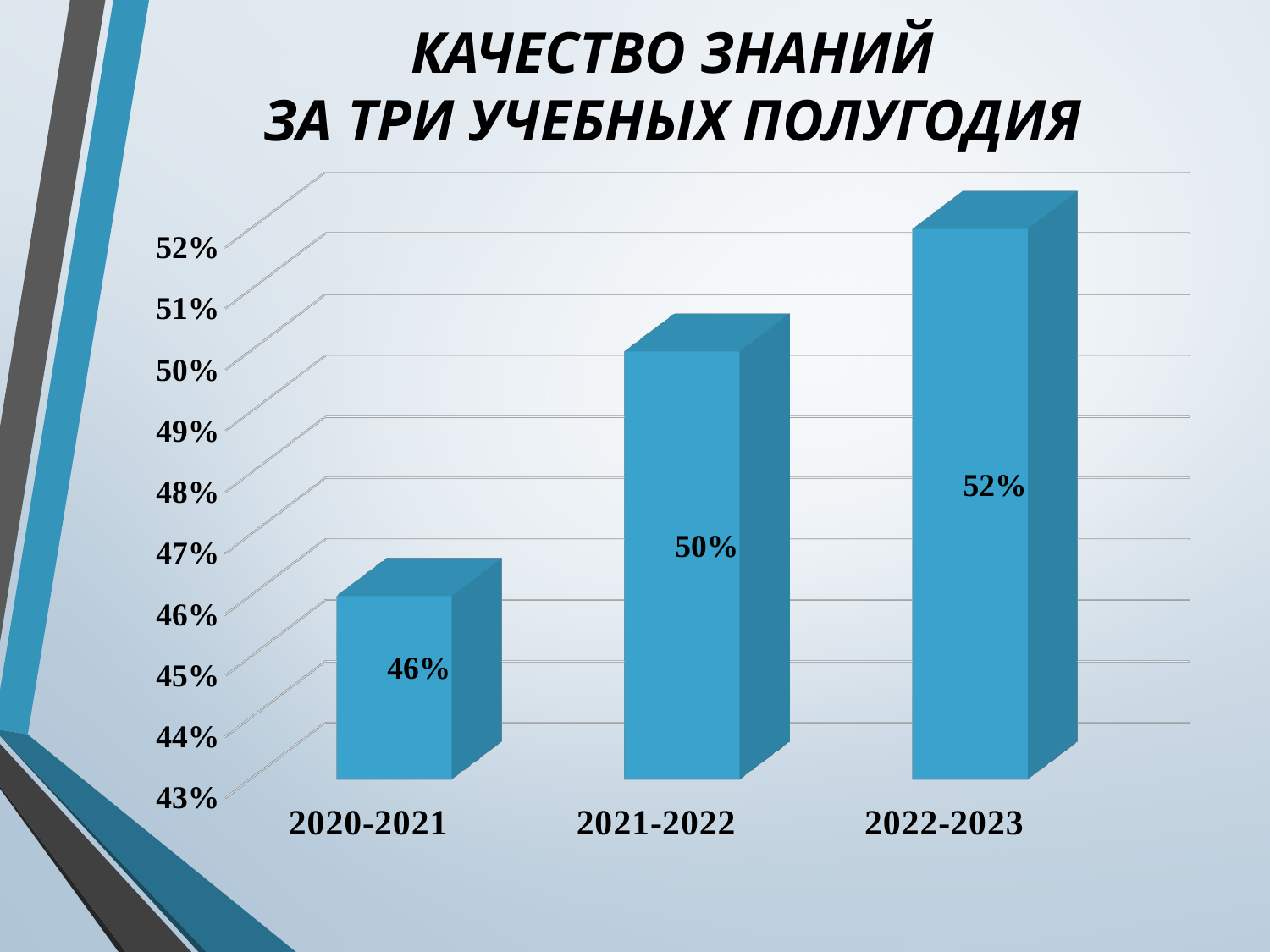
What kind of chart is shown on the slide? bar chart Which is larger, the value for 2021-2022 or the value for 2020-2021? 2021-2022 How many periods are shown on the chart? 3 Which period has the lowest value? 2020-2021 What is the difference between the values for 2022-2023 and 2020-2021? 6% What is the value for 2020-2021? 46% What is the value for 2021-2022? 50% Which period has the highest value? 2022-2023 Do the values rise or fall from 2020-2021 to 2022-2023? rise Is the value for 2020-2021 greater or less than 48%? less What is the value for 2022-2023? 52% What is the difference between the values for 2021-2022 and 2020-2021? 4%